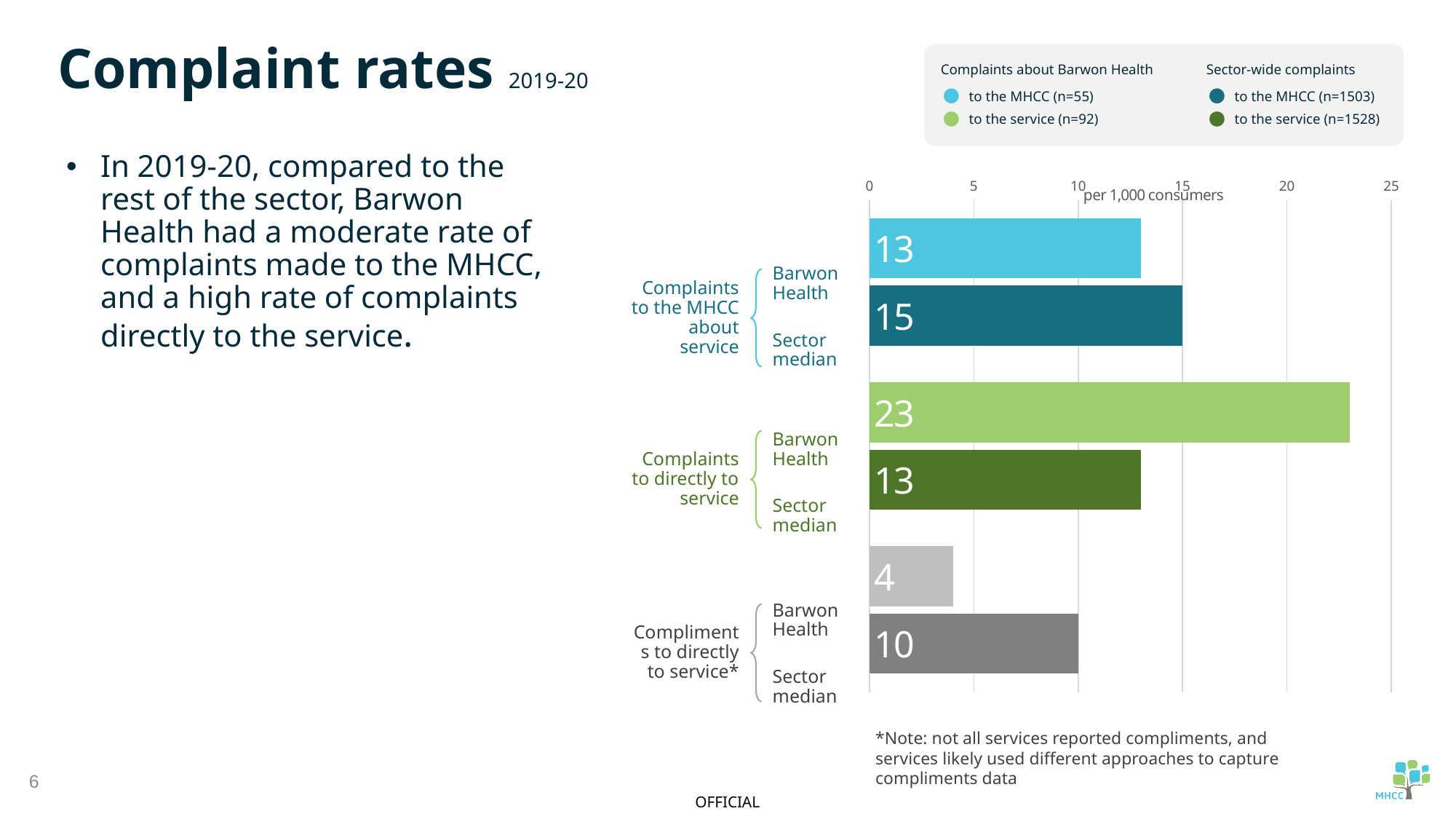
Which bar has the highest value on the chart? Barwon Health complaints directly to service What is the Barwon Health rate of complaints made directly to the service? 23 What is the difference between the sector median and Barwon Health rates for compliments directly to service? 6 Which bar has the lowest value on the chart? Barwon Health compliments directly to service For complaints to the MHCC about service, which is larger: Barwon Health or the sector median? Sector median What is the difference between the Barwon Health rate and the sector median rate for complaints directly to service? 10 What is the Barwon Health rate of complaints to the MHCC about service, per 1,000 consumers? 13 What type of chart is shown on the slide? Bar chart What is the sector median rate of compliments made directly to the service? 10 Is the Barwon Health value for complaints directly to service greater or less than 20? greater What is the sector median rate of complaints to the MHCC about service? 15 What is the sample size (n) shown in the legend for sector-wide complaints to the service? n=1528